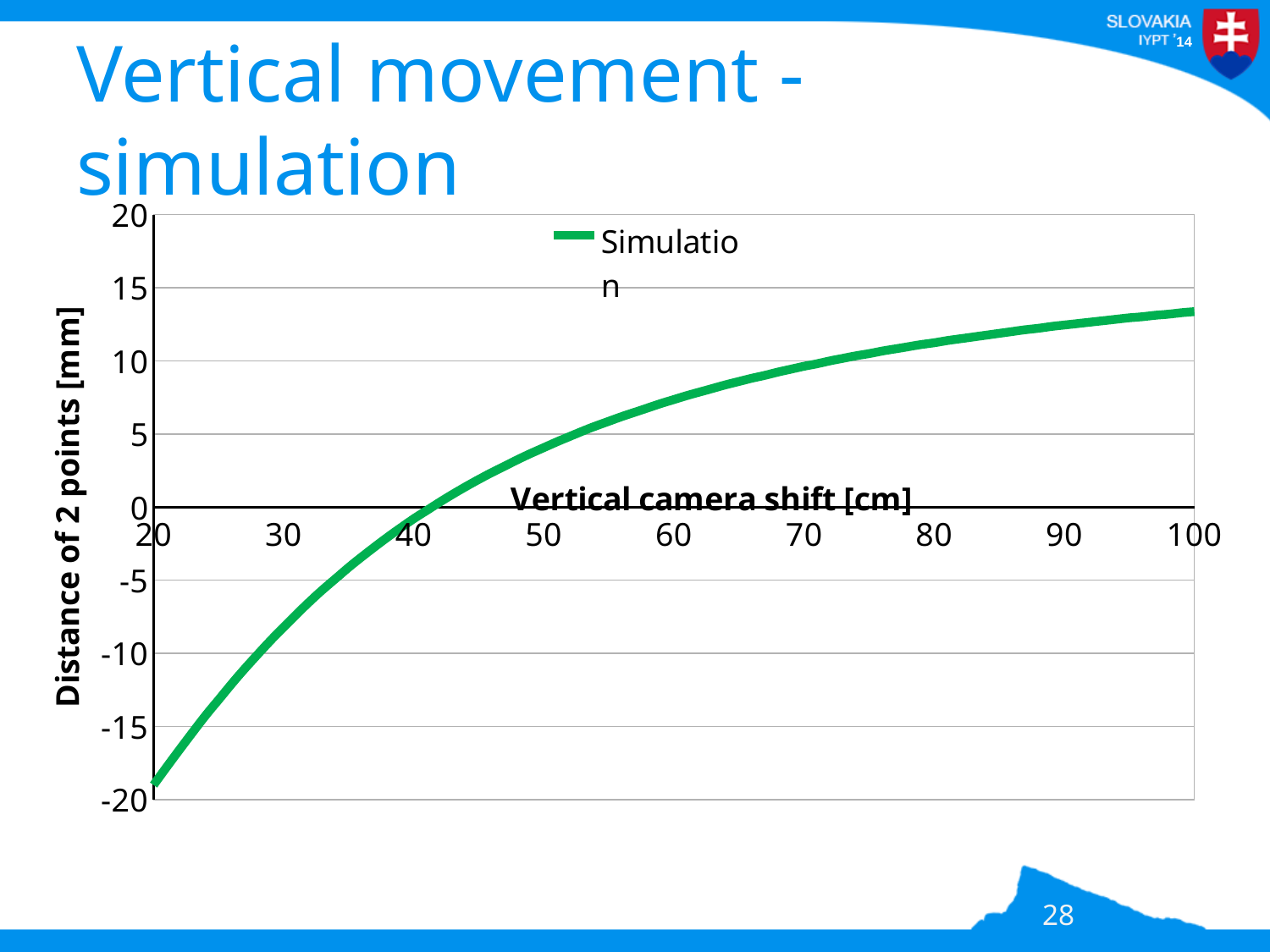
How many series does the legend list? 1 Is the Simulation value at a vertical camera shift of 90 cm greater or less than 10? greater Is the Simulation value at a vertical camera shift of 100 cm greater or less than 10? greater Is the Simulation value at a vertical camera shift of 100 cm greater or less than 15? less What is the name of the series shown in the legend? Simulation What kind of chart is shown on the slide? line chart What is the title of the x axis? Vertical camera shift [cm] Does the Simulation curve rise or fall as the vertical camera shift increases from 20 to 100 cm? rise